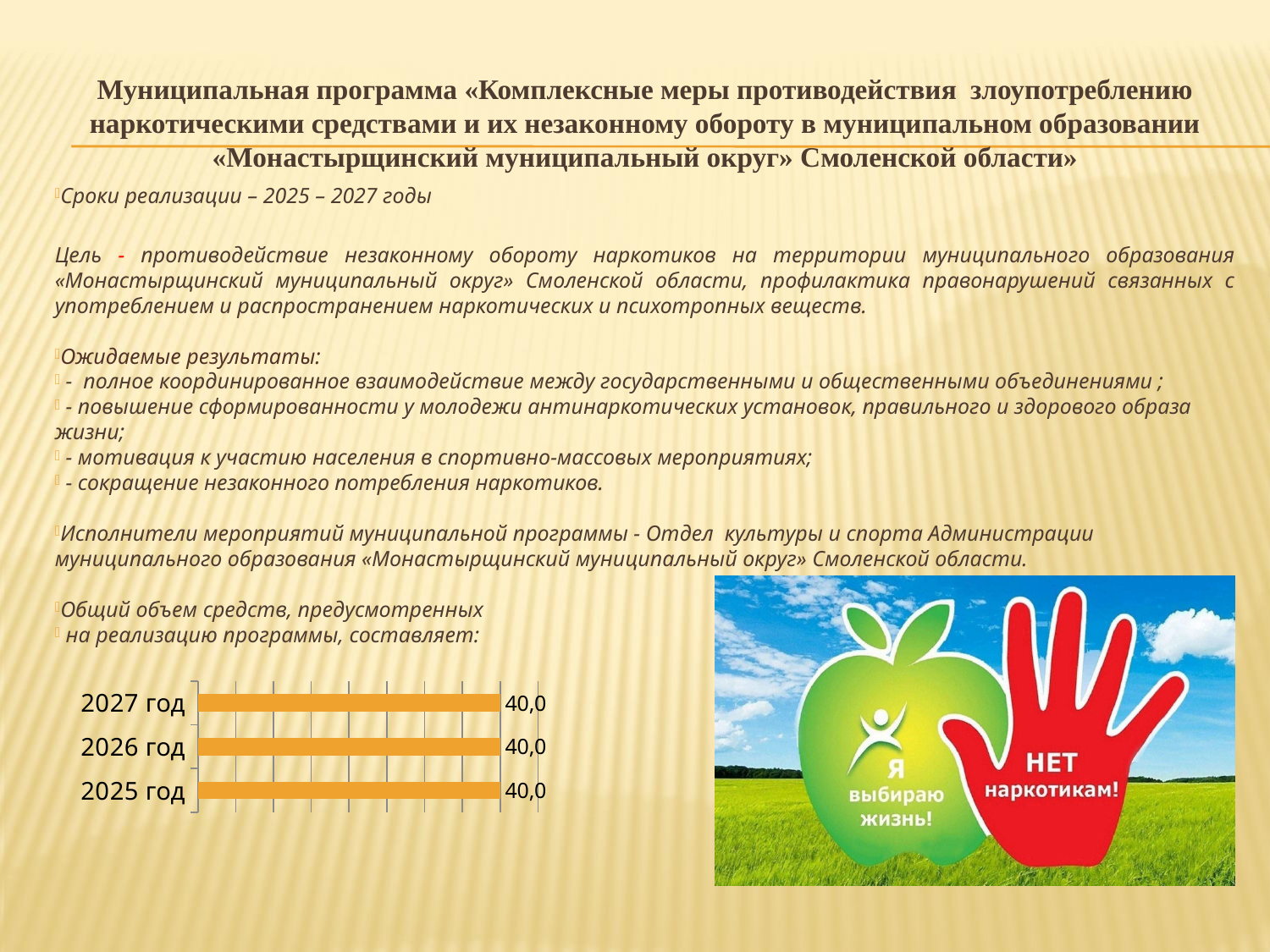
What colour are the bars in the chart? orange What is the difference between the values for 2027 год and 2025 год? 0,0 What is the value for 2025 год in the bar chart? 40,0 What kind of chart is shown on the slide? bar chart How many categories (years) are shown in the bar chart? 3 What is the value for 2027 год in the bar chart? 40,0 What is the value for 2026 год in the bar chart? 40,0 Is the value for 2026 год larger than, smaller than, or equal to the value for 2025 год? equal Do the values rise, fall, or stay the same from 2025 год to 2027 год? stay the same Are the bars in the chart horizontal or vertical? horizontal